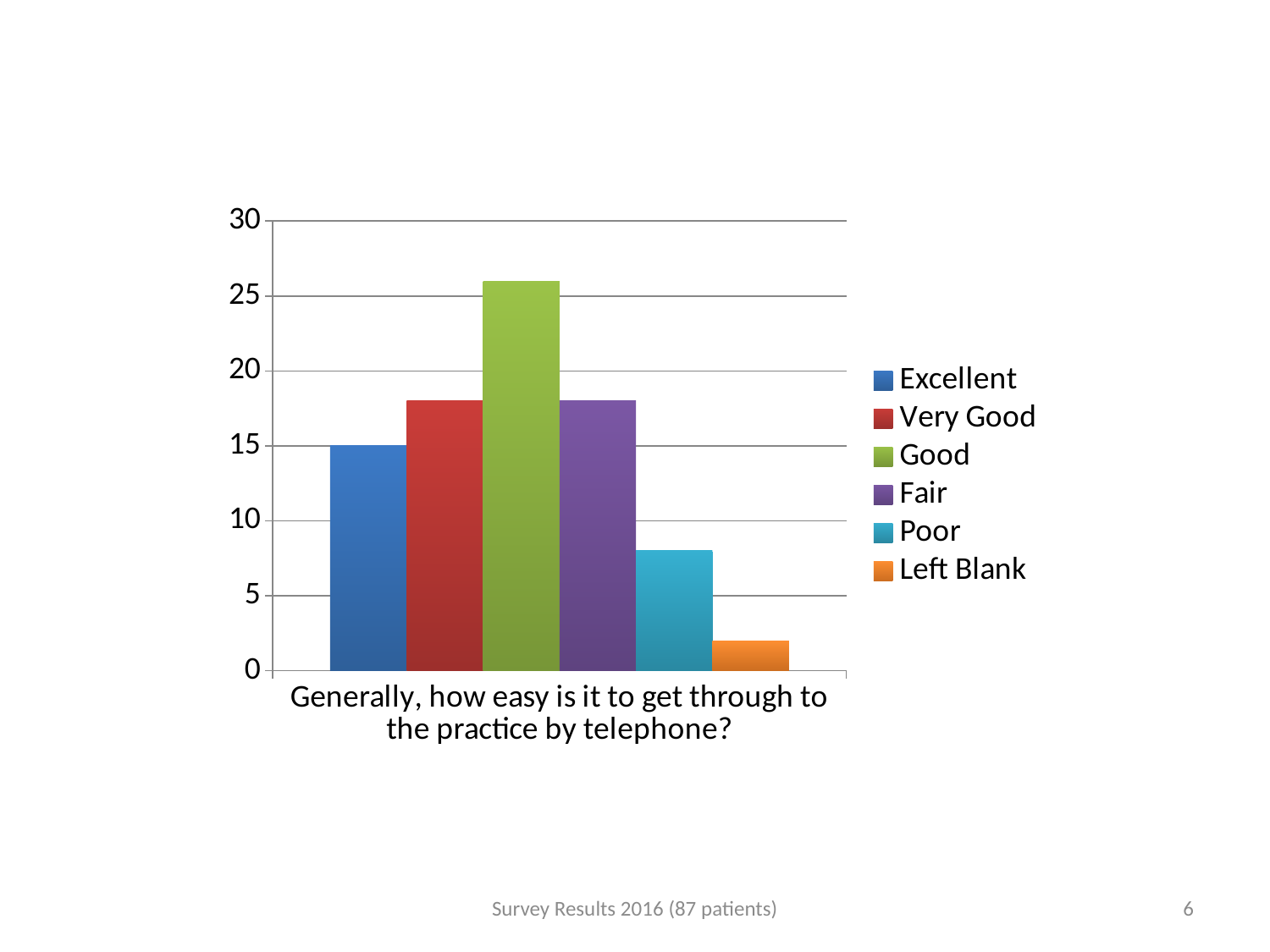
What is the value for Excellent? 15 What kind of chart is shown on the slide? bar chart What question is shown as the category label on the x axis? Generally, how easy is it to get through to the practice by telephone? Is the value for Fair greater or less than 20? less Is the value for Good greater or less than 25? greater Which is larger, the value for Good or the value for Poor? Good What colour is the bar for Good? green Which response has the lowest bar? Left Blank How many series does the legend list? 6 Is the value for Left Blank greater or less than 5? less Which response has the highest bar? Good